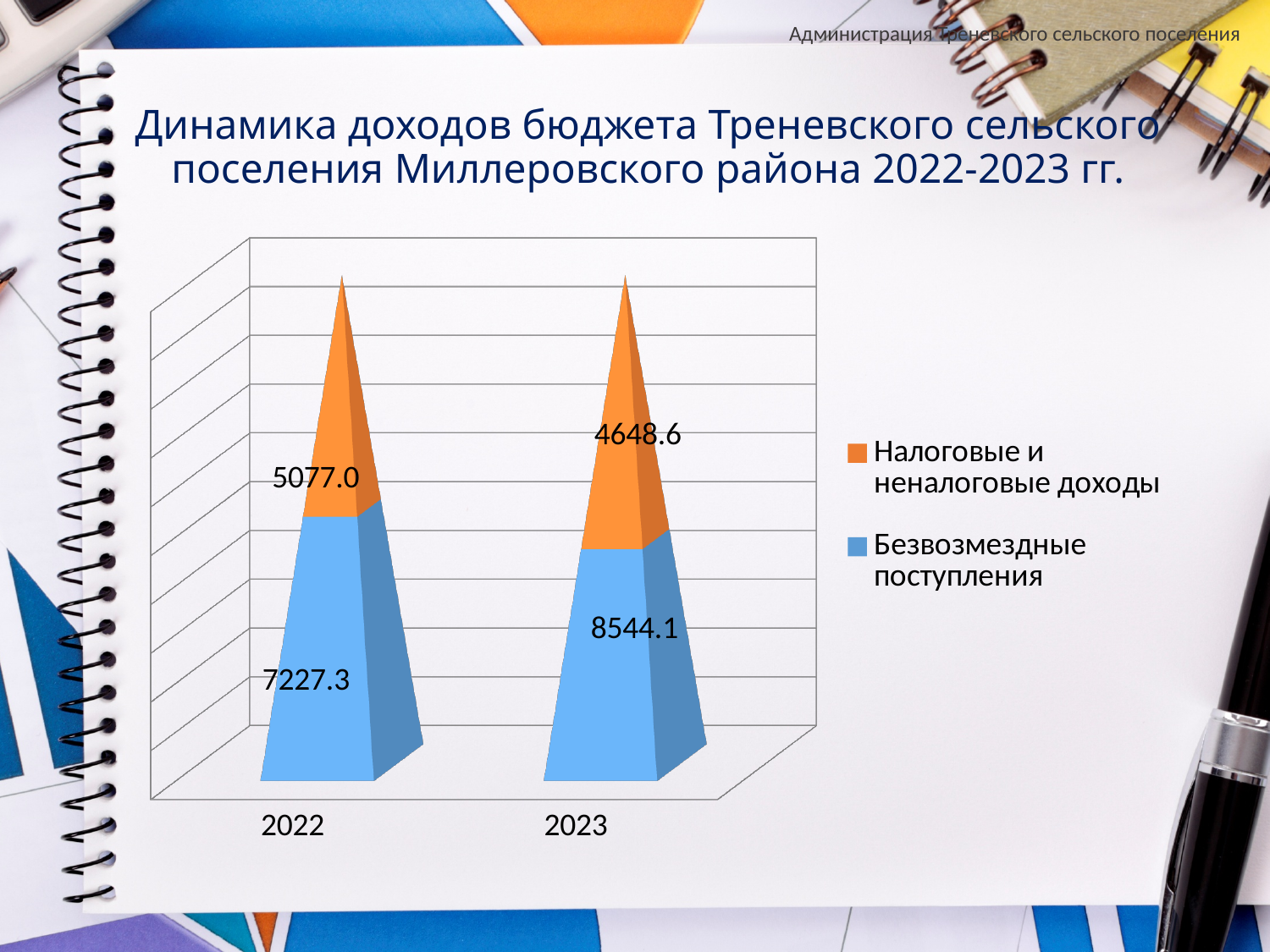
What is the difference between Налоговые и неналоговые доходы in 2022 and in 2023? 428.4 What is the value of Безвозмездные поступления for 2022? 7227.3 What is the value of Налоговые и неналоговые доходы for 2022? 5077.0 What is the total of the stacked bar for 2023? 13192.7 What is the difference between Безвозмездные поступления in 2023 and in 2022? 1316.8 What is the value of Безвозмездные поступления for 2023? 8544.1 Which year has the lower value for Налоговые и неналоговые доходы? 2023 How many years are shown on the x axis? 2 Which year has the higher value for Безвозмездные поступления? 2023 What is the value of Налоговые и неналоговые доходы for 2023? 4648.6 What is the total of the stacked bar for 2022? 12304.3 How many series does the legend list? 2